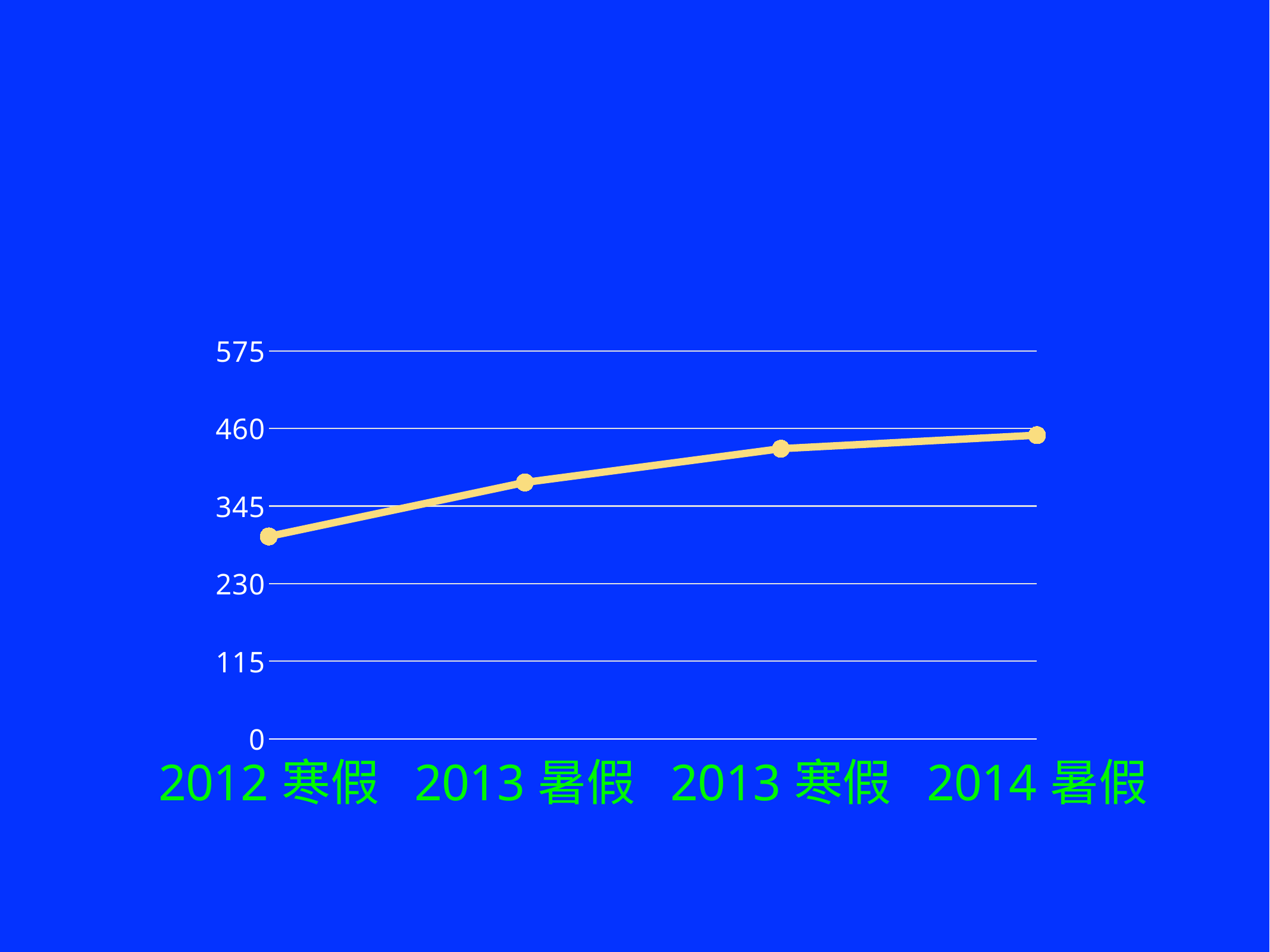
Is the value for 2012 寒假 greater or less than 345? less Is the value for 2013 寒假 greater or less than 460? less Which category has the highest value? 2014 暑假 Which is larger, the value for 2012 寒假 or the value for 2014 暑假? 2014 暑假 How many data points are plotted on the line? 4 Do the values rise or fall from 2012 寒假 to 2014 暑假? rise Is the value for 2013 暑假 greater or less than 345? greater What kind of chart is shown on the slide? line chart Which is larger, the value for 2012 寒假 or the value for 2013 暑假? 2013 暑假 What is the highest value shown on the vertical axis? 575 Which category has the lowest value? 2012 寒假